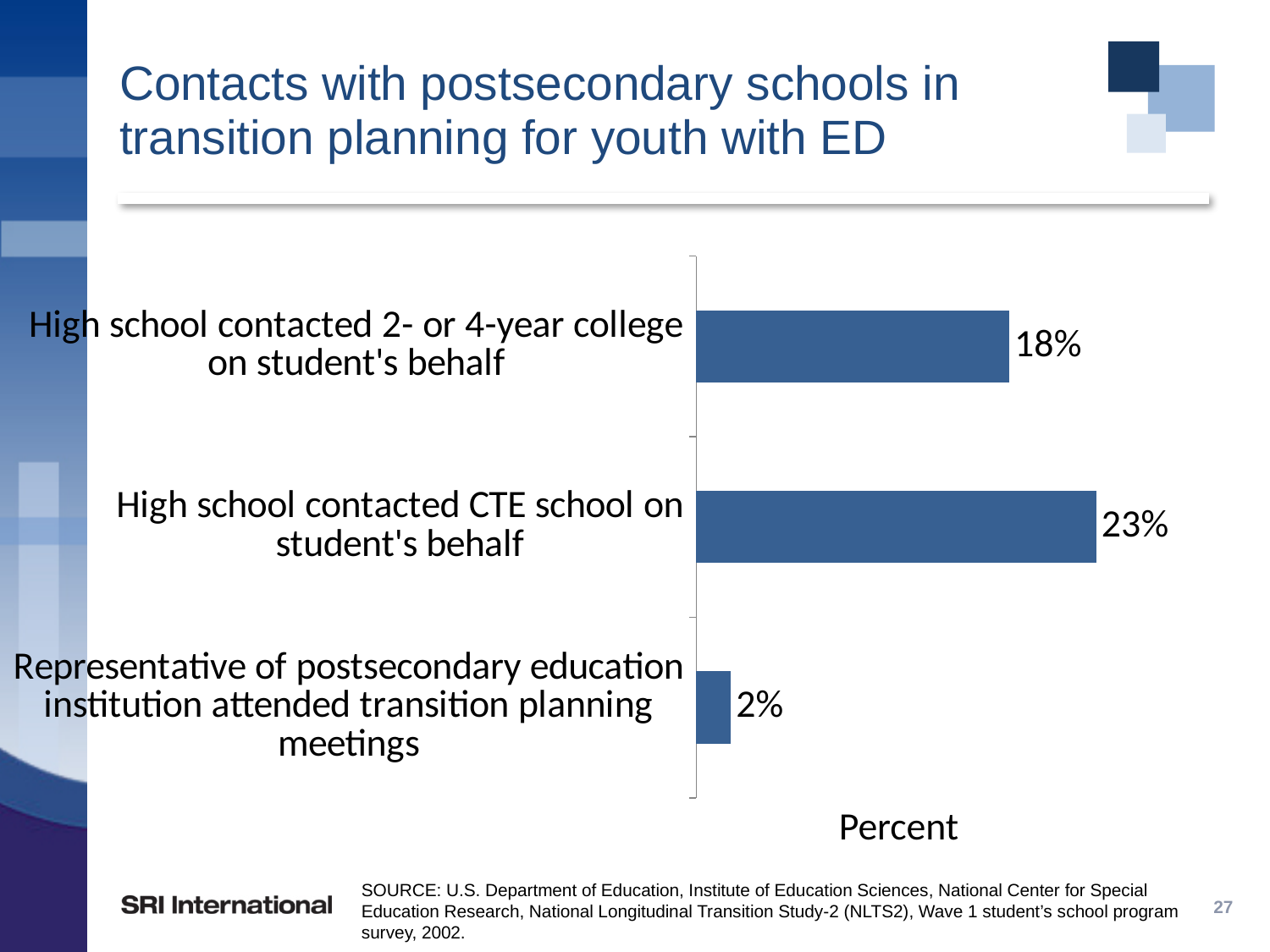
What percentage of youth with ED had their high school contact a 2- or 4-year college on the student's behalf? 18% Which category has the highest percentage? High school contacted CTE school on student's behalf What type of chart is shown on the slide? Bar chart What is the difference in percentage points between high school contacting a CTE school and high school contacting a 2- or 4-year college? 5 percentage points What is the label on the horizontal axis of the chart? Percent What percentage of youth with ED had a representative of a postsecondary education institution attend transition planning meetings? 2% What percentage of youth with ED had their high school contact a CTE school on the student's behalf? 23% Which category has the lowest percentage? Representative of postsecondary education institution attended transition planning meetings Which is larger: the percentage for high school contacting a 2- or 4-year college or the percentage for high school contacting a CTE school? High school contacted CTE school on student's behalf What is the title of the slide? Contacts with postsecondary schools in transition planning for youth with ED How many categories are shown in the chart? 3 What is the difference in percentage points between high school contacting a 2- or 4-year college and a postsecondary representative attending transition planning meetings? 16 percentage points